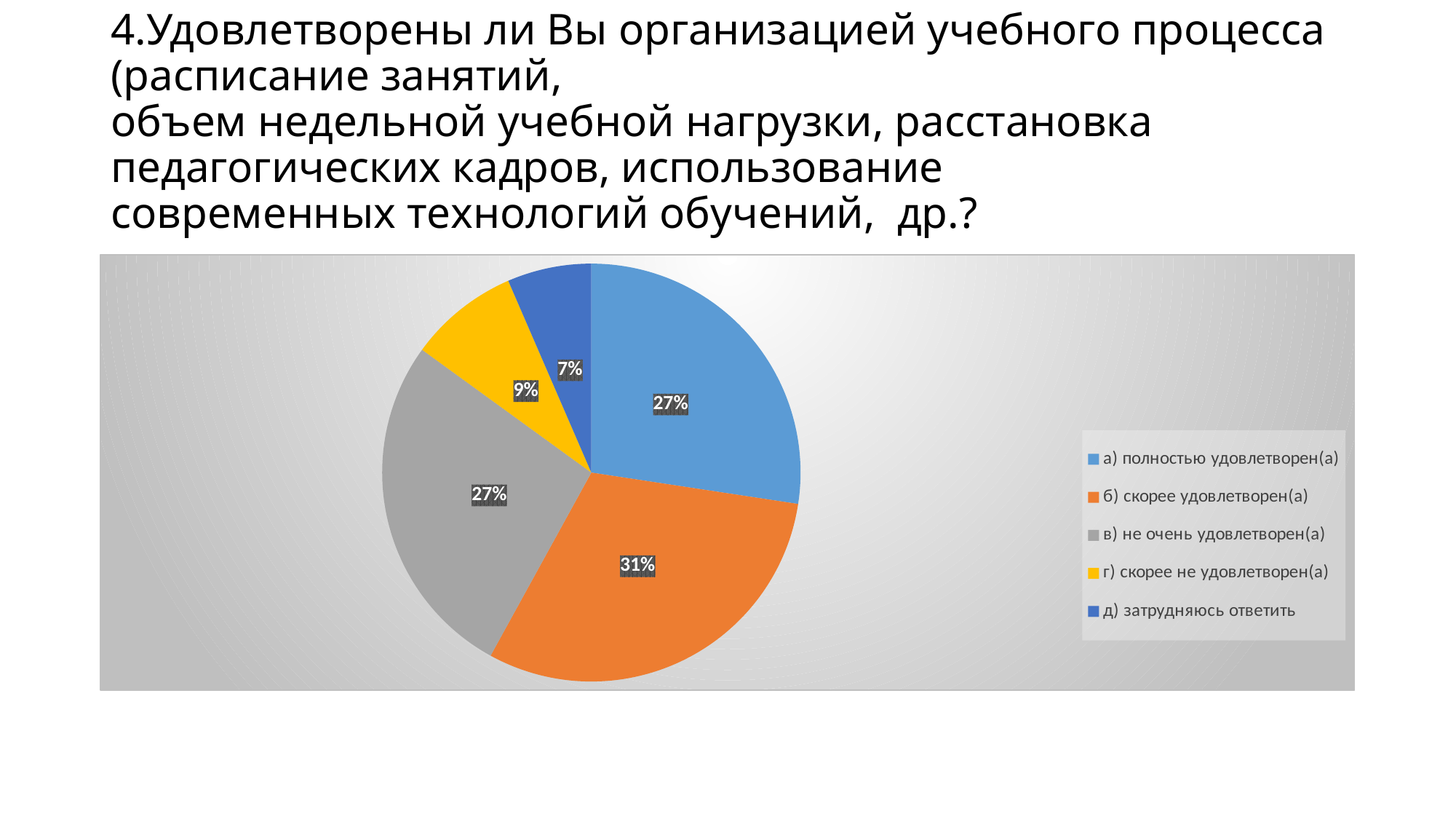
What colour is the slice for "г) скорее не удовлетворен(а)"? yellow What share of the pie is labelled for "в) не очень удовлетворен(а)"? 27% How many categories does the legend list? 5 What share of the pie is labelled for "д) затрудняюсь ответить"? 7% Which category has the smallest slice of the pie? д) затрудняюсь ответить What kind of chart is shown on the slide? pie chart Which is larger, the slice for "г) скорее не удовлетворен(а)" or the slice for "д) затрудняюсь ответить"? г) скорее не удовлетворен(а) What share of the pie is labelled for "г) скорее не удовлетворен(а)"? 9% What is the difference in percentage points between "б) скорее удовлетворен(а)" and "г) скорее не удовлетворен(а)"? 22 What share of the pie is labelled for "б) скорее удовлетворен(а)"? 31% What share of the pie is labelled for "а) полностью удовлетворен(а)"? 27% Which category has the largest slice of the pie? б) скорее удовлетворен(а)